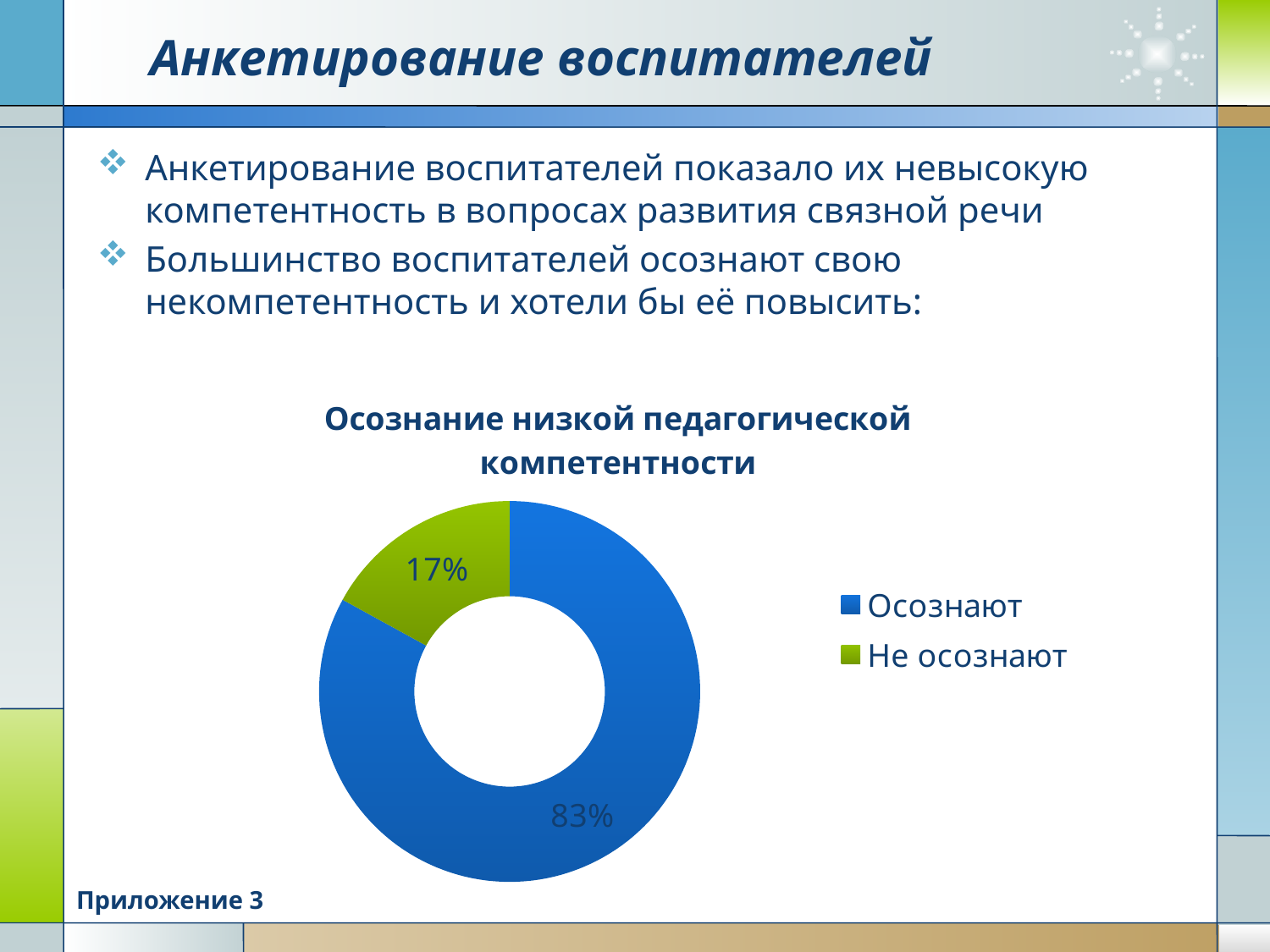
Which category has the largest slice in the chart? Осознают What share of the chart does the "Не осознают" slice represent? 17% What is the difference in percentage points between the "Осознают" and "Не осознают" slices? 66 Is the share for "Осознают" greater or less than 50%? greater How many categories does the chart show? 2 Which slice is larger, "Осознают" or "Не осознают"? Осознают What colour is the "Не осознают" slice? Green What share of the chart does the "Осознают" slice represent? 83% What kind of chart is shown on the slide? Pie chart (doughnut) What is the title of the chart? Осознание низкой педагогической компетентности Which category has the smallest slice in the chart? Не осознают